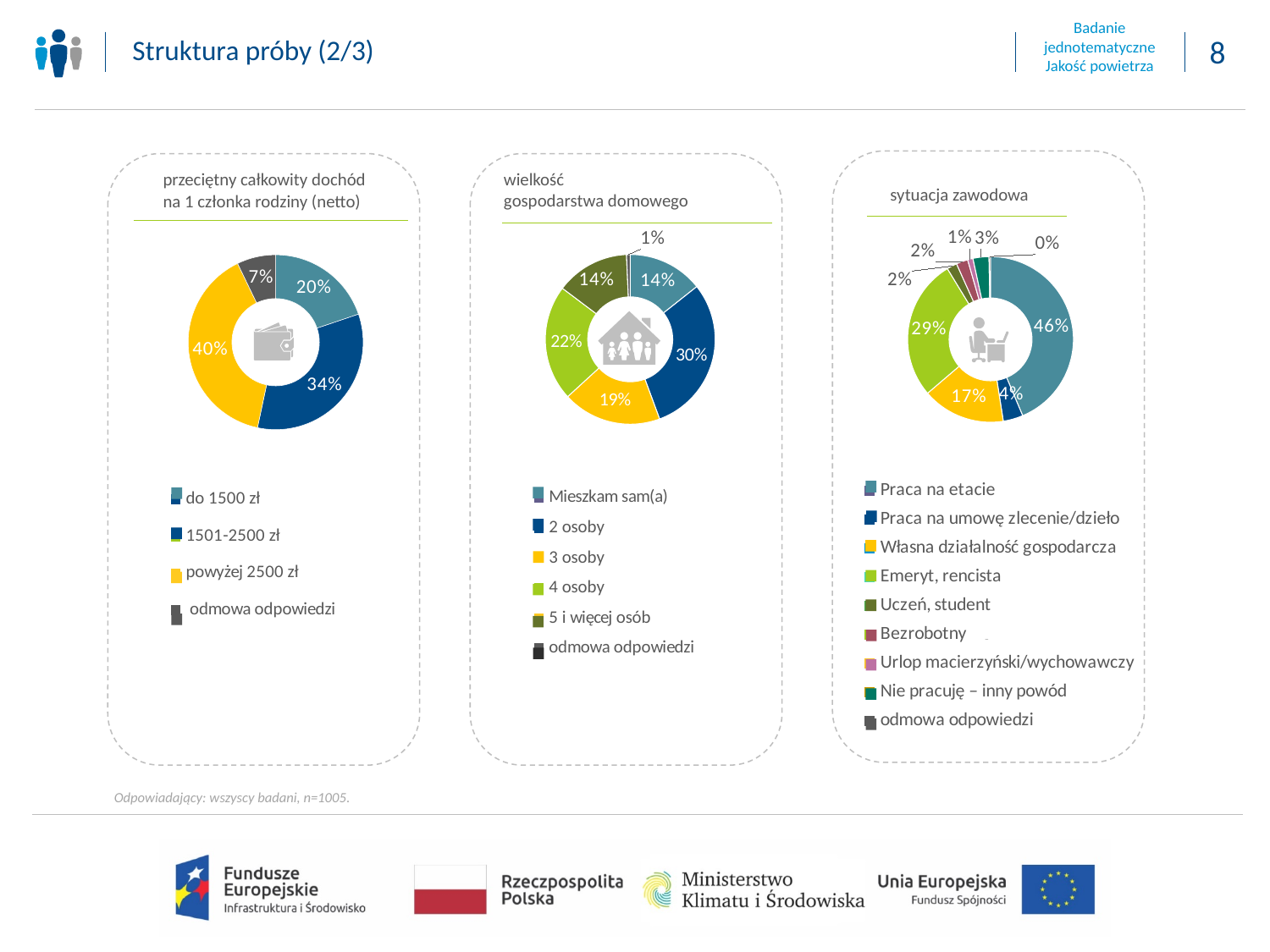
In the chart 'wielkość gospodarstwa domowego', how many categories does the legend list? 6 In the chart 'sytuacja zawodowa', what share is 'odmowa odpowiedzi'? 0% What type of chart is used for 'sytuacja zawodowa'? Pie (donut) chart In the chart 'przeciętny całkowity dochód na 1 członka rodziny (netto)', what is the difference between '1501-2500 zł' and 'do 1500 zł'? 14% In the chart 'sytuacja zawodowa', what share is 'Emeryt, rencista'? 29% In the chart 'wielkość gospodarstwa domowego', which category has the largest share? 2 osoby In the chart 'sytuacja zawodowa', how many categories does the legend list? 9 In the chart 'wielkość gospodarstwa domowego', what share is '2 osoby'? 30% In the chart 'wielkość gospodarstwa domowego', which is larger: '3 osoby' or '4 osoby'? 4 osoby In the chart 'przeciętny całkowity dochód na 1 członka rodziny (netto)', what share is 'powyżej 2500 zł'? 40% In the chart 'przeciętny całkowity dochód na 1 członka rodziny (netto)', which category has the smallest share? odmowa odpowiedzi In the chart 'sytuacja zawodowa', what share is 'Praca na etacie'? 46%